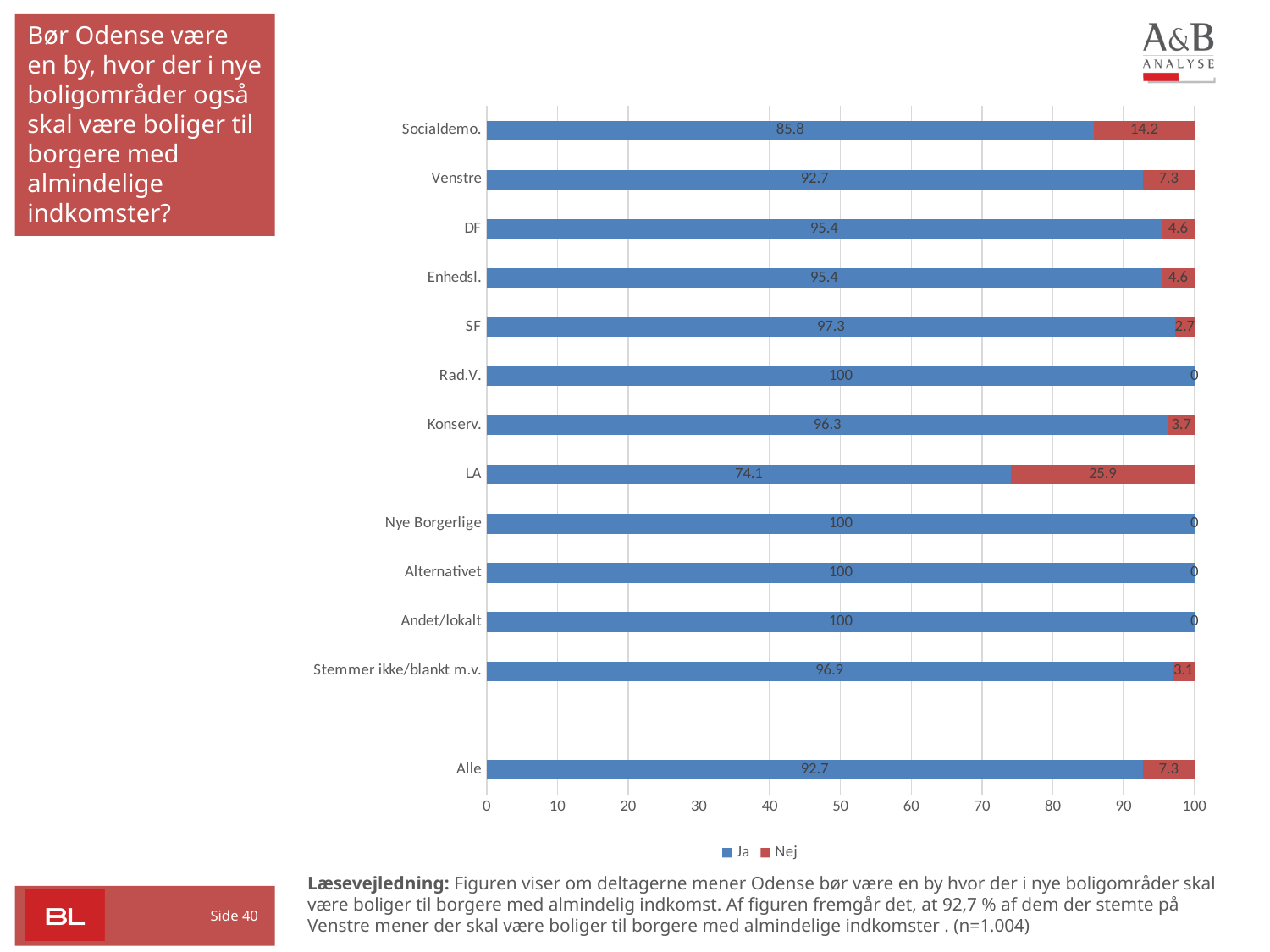
How many categories are shown on the y axis of the chart? 13 Which has a larger "Nej" value, Socialdemo. or Venstre? Socialdemo. What is the total of the stacked bar for SF? 100 What is the difference between the "Ja" values for Venstre and Socialdemo.? 6.9 How many series does the legend list? 2 Which category has the lowest "Ja" value? LA What is the "Nej" value for LA? 25.9 What is the "Ja" value for Socialdemo.? 85.8 What kind of chart is shown on the slide? Stacked bar chart Which category has the highest "Nej" value? LA What is the "Nej" value for Konserv.? 3.7 What is the "Ja" value for Alle? 92.7